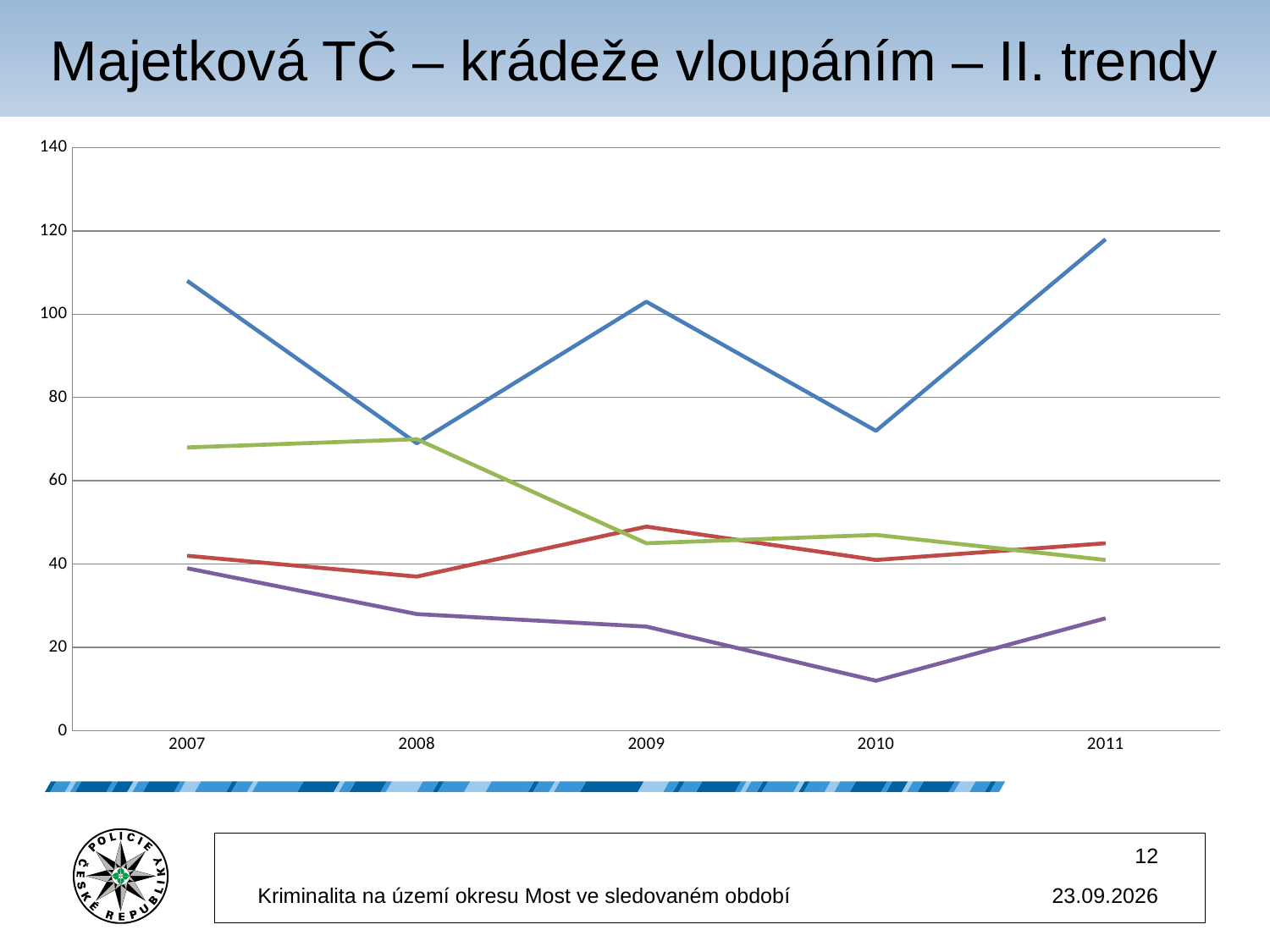
How many lines are plotted on the chart? 4 In which year does the blue line reach its highest value? 2011 Does the purple line rise or fall from 2007 to 2010? fall Which line has the higher value in 2007, the green line or the red line? green line Is the value of the green line in 2007 greater or less than 60? greater Is the value of the purple line in 2010 greater or less than 20? less Is the value of the blue line in 2011 greater or less than 100? greater What kind of chart is shown on the slide? line chart In which year does the purple line reach its lowest value? 2010 How many years are shown on the x axis of the chart? 5 What is the title of the slide? Majetková TČ – krádeže vloupáním – II. trendy